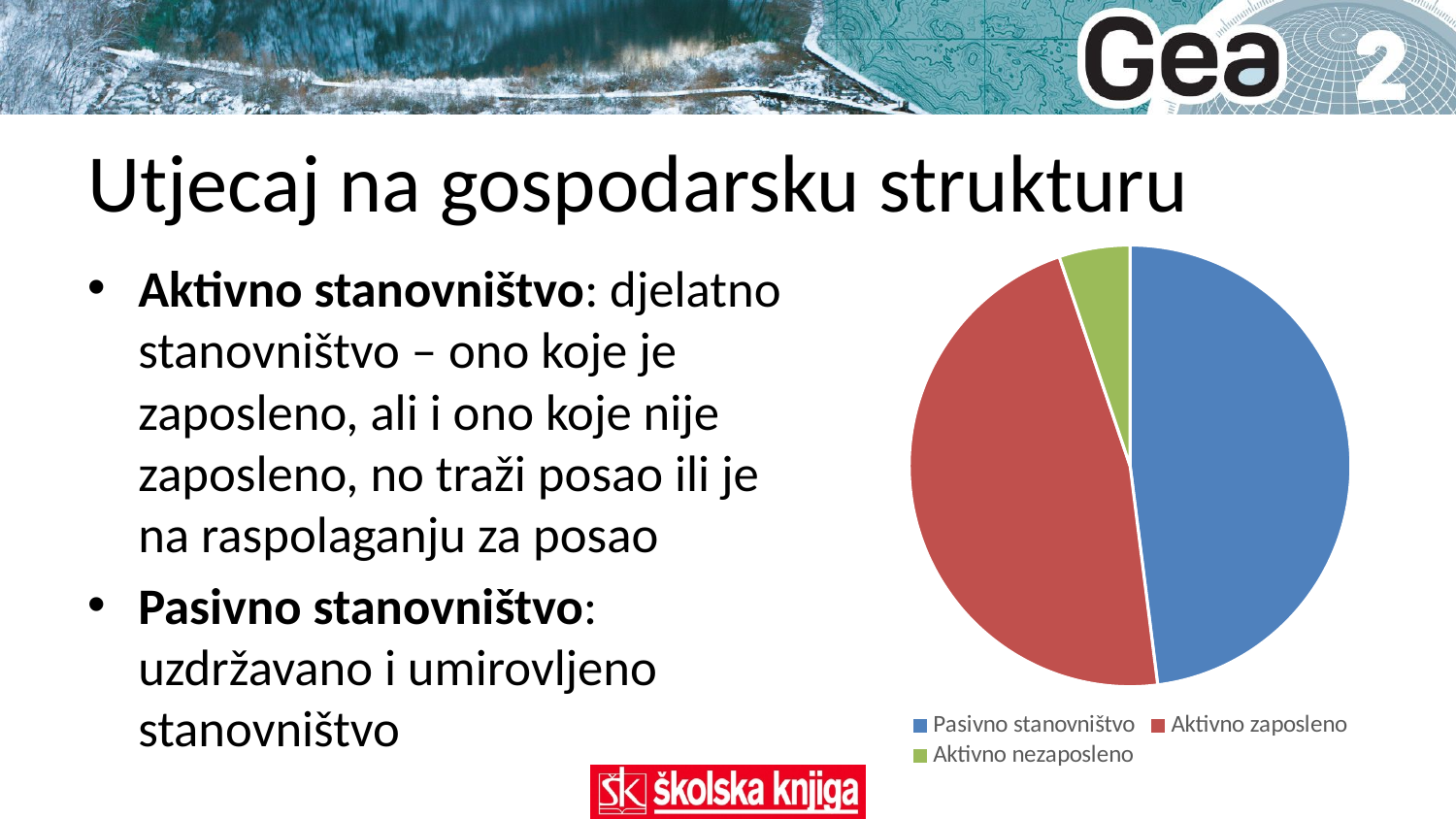
What kind of chart is shown on the slide? pie chart How many slices does the pie chart have? 3 What colour is the Aktivno nezaposleno slice in the pie chart? green Which category is shown in blue in the pie chart? Pasivno stanovništvo Which slice is larger in the pie chart, Pasivno stanovništvo or Aktivno nezaposleno? Pasivno stanovništvo Which slice is larger in the pie chart, Aktivno zaposleno or Aktivno nezaposleno? Aktivno zaposleno Which category has the smallest slice in the pie chart? Aktivno nezaposleno How many entries does the legend of the pie chart list? 3